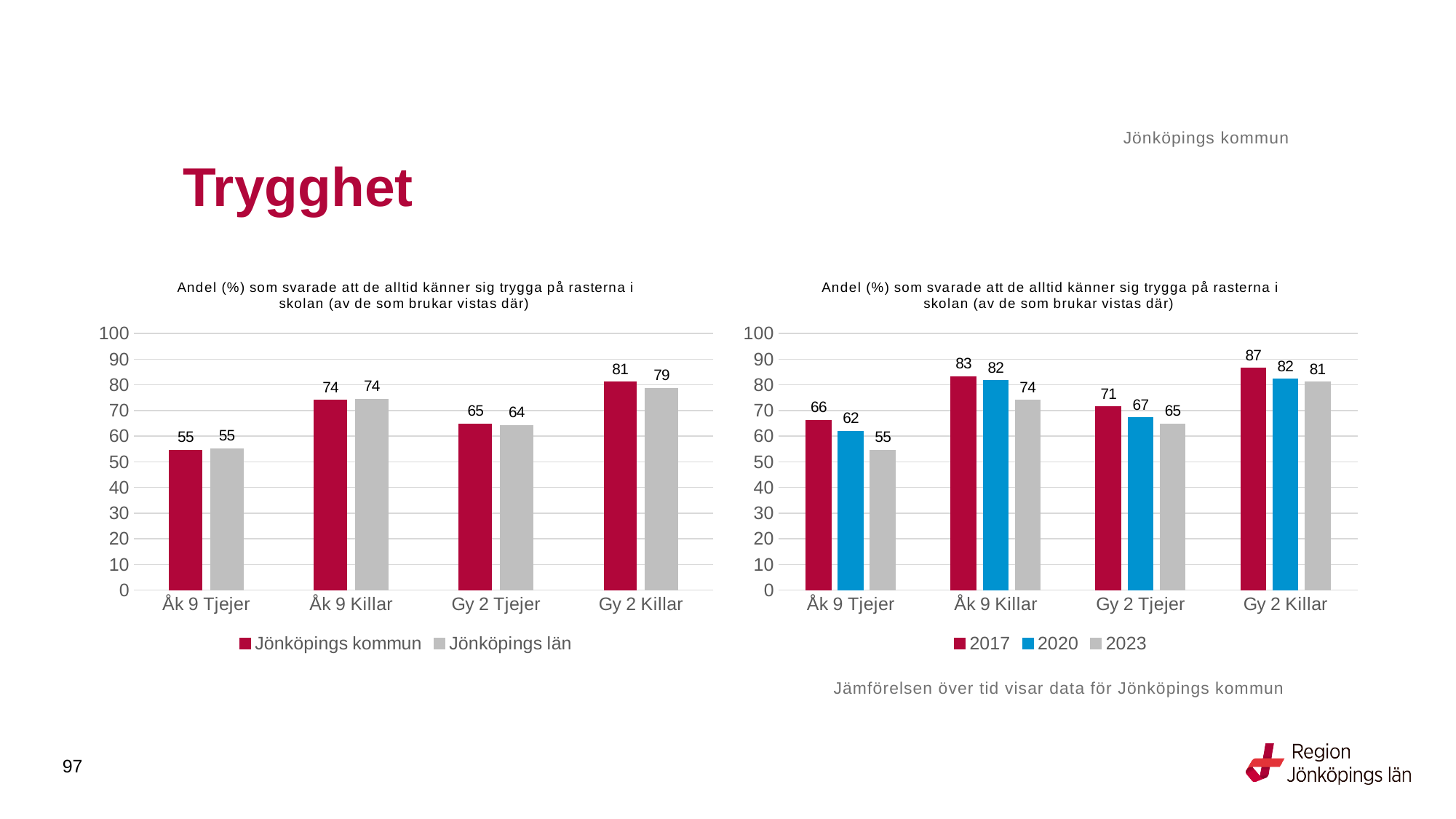
In the right chart, how many series does the legend list? 3 What kind of chart is the right chart? Bar chart In the left chart, how many series does the legend list? 2 In the left chart, which category has the lowest value for Jönköpings kommun? Åk 9 Tjejer In the right chart, which category has the highest 2017 value? Gy 2 Killar In the right chart, what is the 2020 value for Åk 9 Tjejer? 62 In the left chart, what is the difference between Jönköpings kommun and Jönköpings län for Gy 2 Killar? 2 In the right chart, what is the difference between the 2017 and 2023 values for Åk 9 Tjejer? 11 In the left chart, what is the value for Jönköpings län for Gy 2 Tjejer? 64 In the left chart, what is the value for Jönköpings kommun for Gy 2 Killar? 81 In the right chart, what is the 2023 value for Gy 2 Killar? 81 In the right chart, is the 2017 value for Gy 2 Tjejer larger or the 2023 value for Åk 9 Killar? 2023 value for Åk 9 Killar